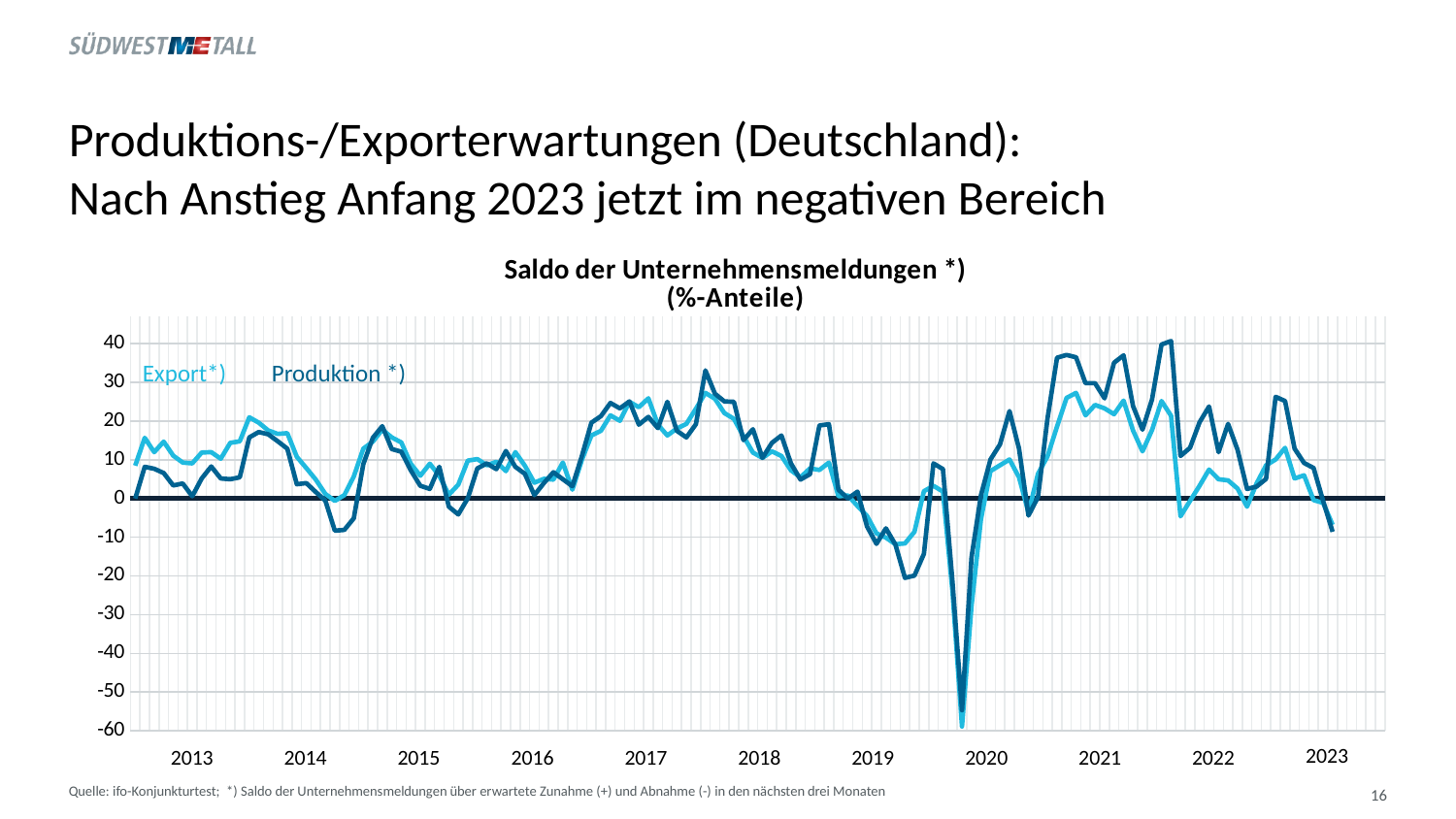
Is the lowest value of the Produktion series in 2019 greater or less than -10? less Which series reaches the higher peak in 2021, Export or Produktion? Produktion What is the title of the chart? Saldo der Unternehmensmeldungen *) (%-Anteile) Is the last plotted value of the Produktion series in 2023 greater or less than 0? less How many series does the chart's legend list? 2 How many years are labelled on the x axis of the chart? 11 Is the highest value of the Produktion series in 2021 greater or less than 30? greater What are the names of the two series in the chart? Export and Produktion What kind of chart is shown on the slide? line chart Do the values of both series rise or fall from the end of 2022 to 2023? fall